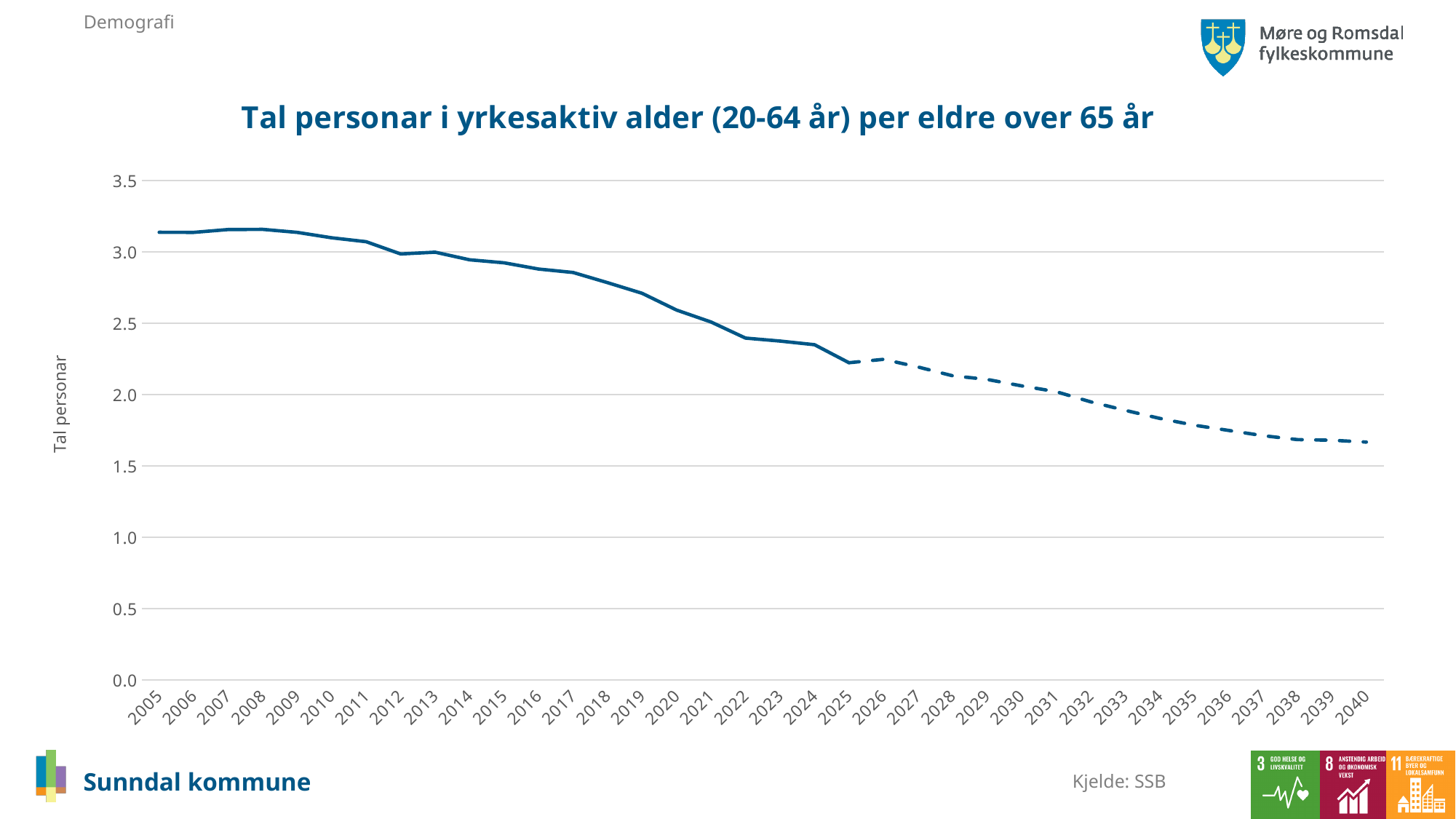
How many years are shown on the x axis of the chart? 36 Which year has the larger value, 2010 or 2030? 2010 Is the value for 2005 greater or less than 3.0? greater Do the values rise or fall from 2005 to 2040? fall Is the value for 2040 greater or less than 2.0? less What is the label on the vertical axis of the chart? Tal personar Is the value for 2020 greater or less than 2.5? greater What kind of chart is shown on the slide? line chart What is the title of the chart? Tal personar i yrkesaktiv alder (20-64 år) per eldre over 65 år Which year has the larger value, 2005 or 2040? 2005